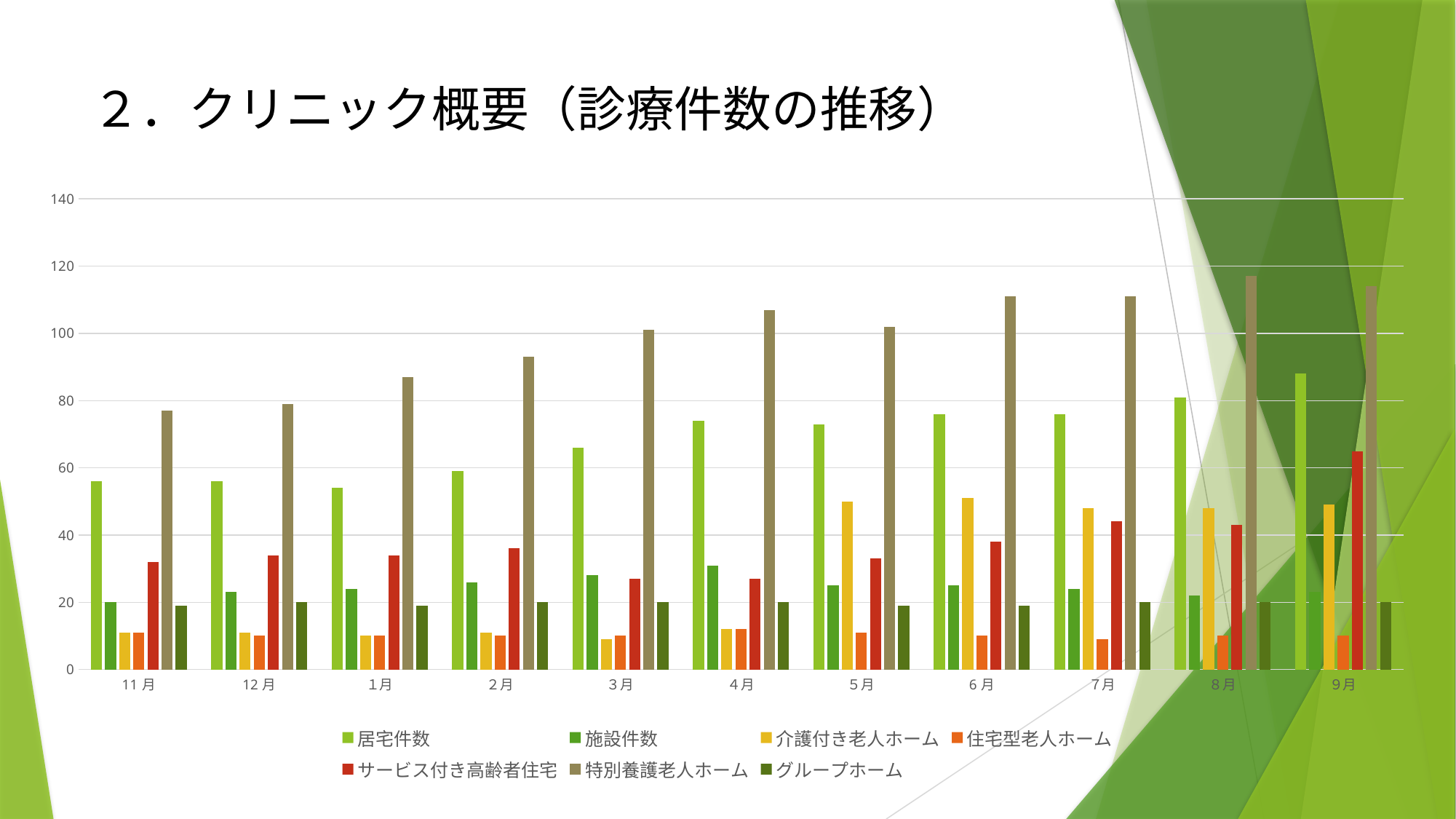
What kind of chart is shown on the slide? bar chart Do the values for 特別養護老人ホーム rise or fall from 11月 to 4月? rise Is the value for 住宅型老人ホーム in 7月 greater or less than 20? less What is the title of the slide containing the chart? 2．クリニック概要（診療件数の推移） Is the value for 特別養護老人ホーム in 8月 greater or less than 100? greater Which is larger, the value for サービス付き高齢者住宅 in 9月 or in 8月? 9月 Which series has the lowest value in 9月? 住宅型老人ホーム Is the value for 居宅件数 in 11月 greater or less than 60? less Which series has the highest value in 4月? 特別養護老人ホーム How many series does the chart's legend list? 7 How many months are shown on the x axis of the chart? 11